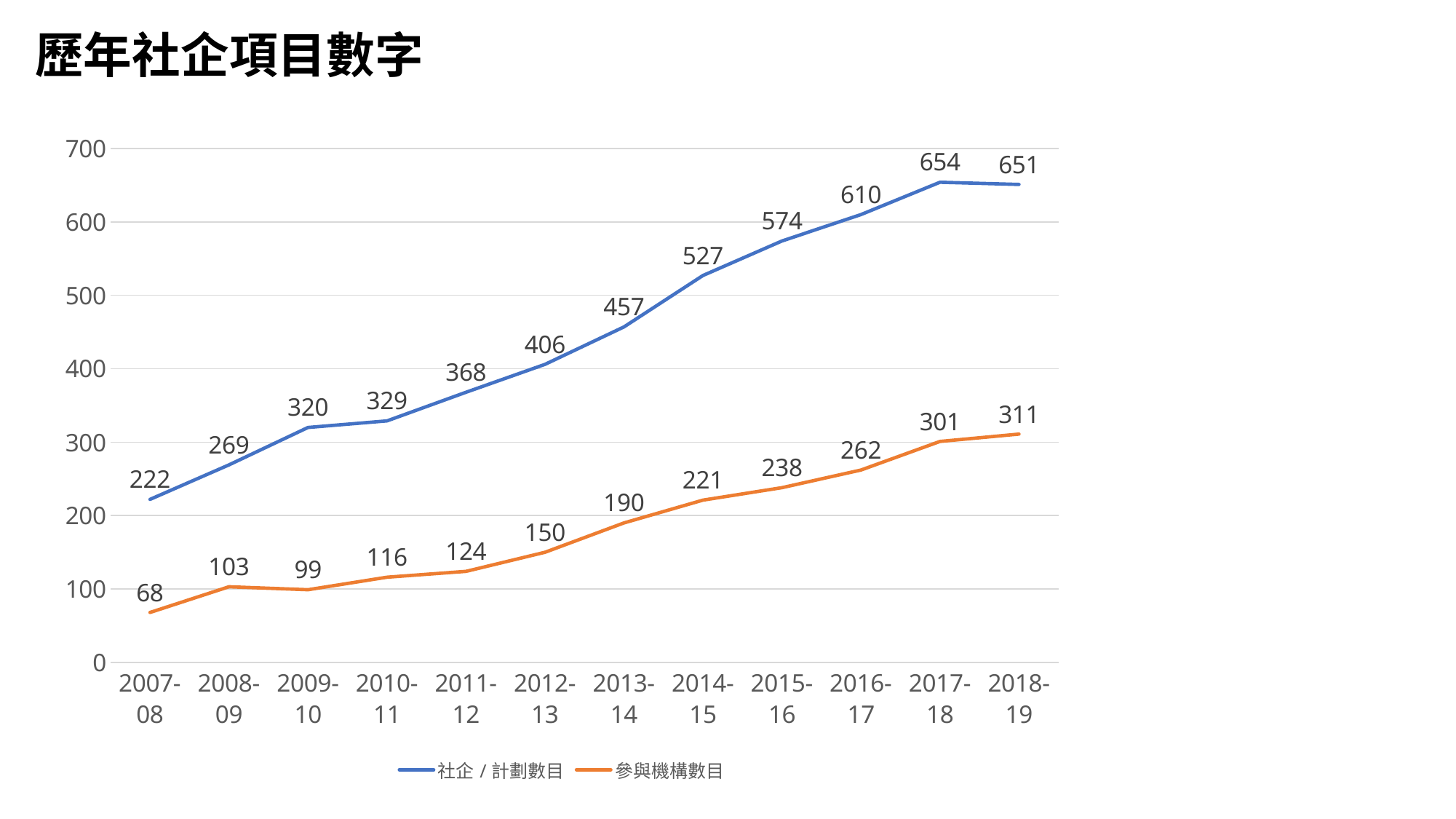
What is the value of 社企 / 計劃數目 for 2013-14? 457 In which year is 參與機構數目 at its lowest? 2007-08 In which year does 社企 / 計劃數目 reach its highest value? 2017-18 By how much did 參與機構數目 increase from 2007-08 to 2018-19? 243 Is the value of 社企 / 計劃數目 for 2014-15 greater or less than 500? greater How many series does the legend list? 2 What is the value of 參與機構數目 for 2010-11? 116 What kind of chart is shown on the slide? Line chart How many years are shown on the x axis? 12 What is the title of the slide? 歷年社企項目數字 What is the difference between 社企 / 計劃數目 and 參與機構數目 in 2018-19? 340 Which is larger: 社企 / 計劃數目 in 2009-10 or in 2010-11? 2010-11